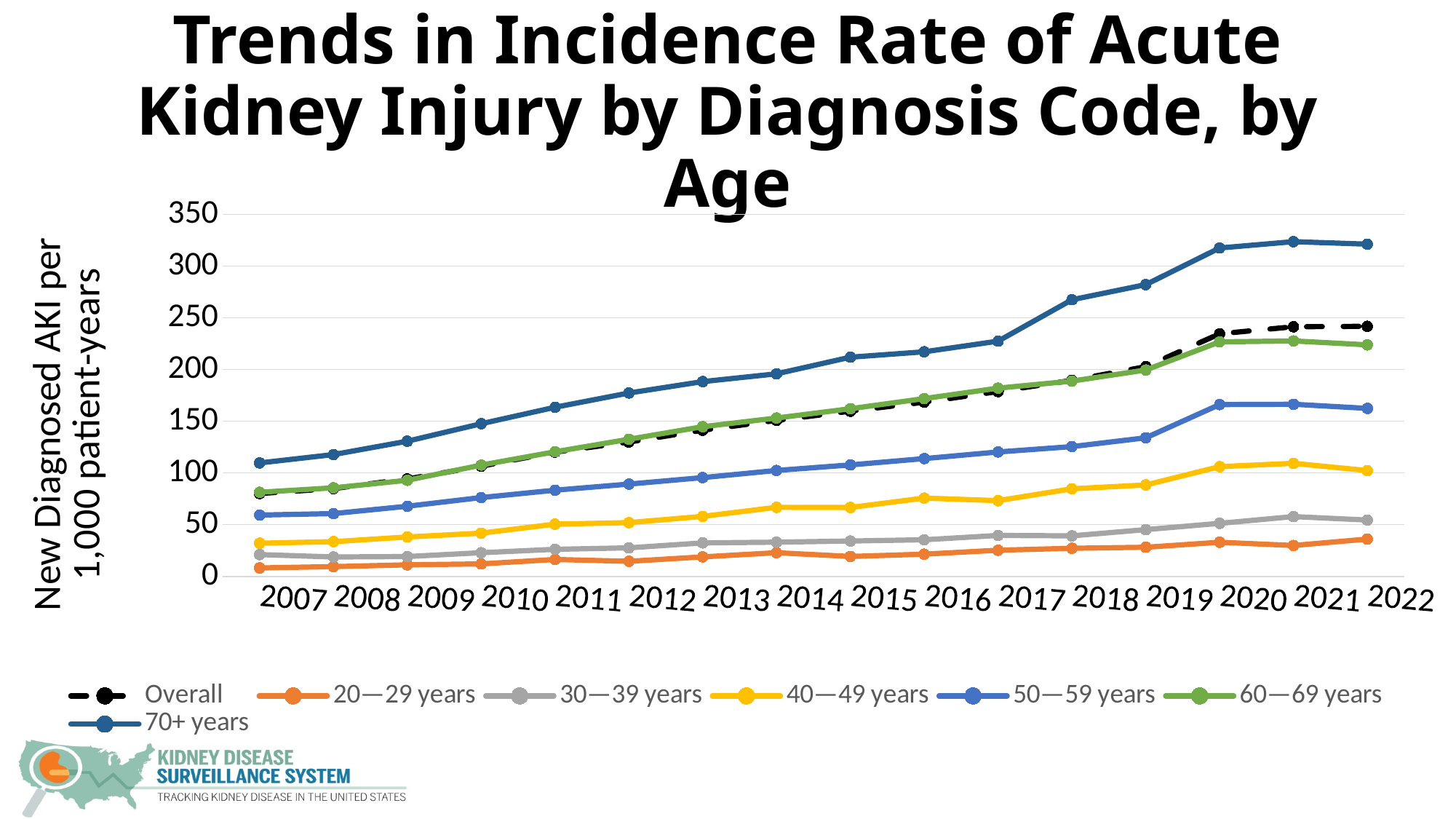
What is the label of the y axis? New Diagnosed AKI per 1,000 patient-years How many series does the legend list? 7 Which age group has the lowest incidence rate in 2022? 20—29 years Is the value for 20—29 years in 2007 greater or less than 50? less In 2015, which is larger: the value for 50—59 years or the value for 40—49 years? 50—59 years Is the value for 30—39 years in 2022 greater or less than 100? less Does the incidence rate for 70+ years generally rise or fall from 2007 to 2022? rise How many years are plotted along the x axis? 16 What kind of chart is shown on the slide? line chart Is the value for 60—69 years in 2022 greater or less than 200? greater Which age group has the highest incidence rate in 2022? 70+ years